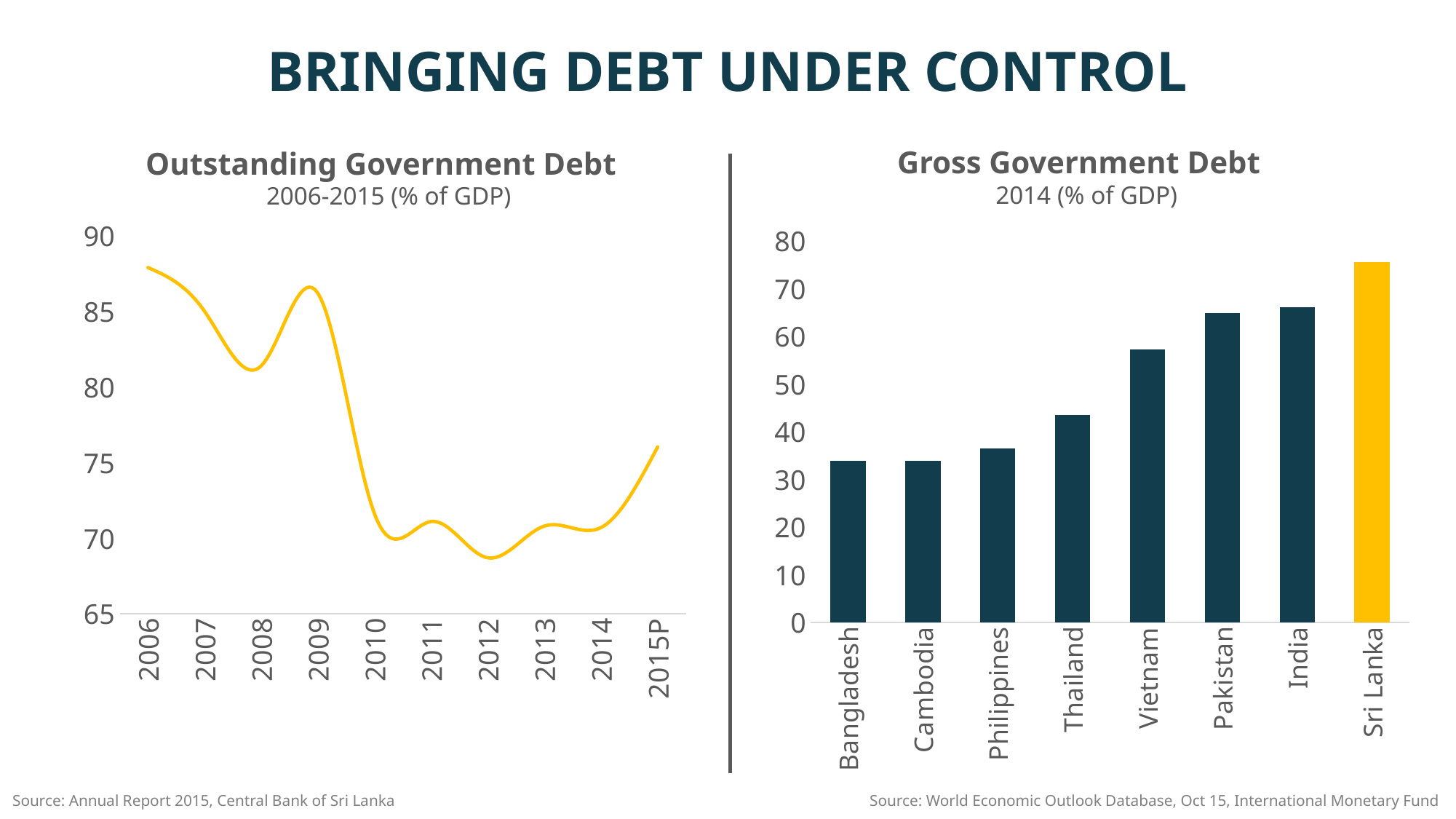
On the Gross Government Debt chart, is the value for Sri Lanka greater or less than 70? greater On the Outstanding Government Debt chart, which year has the highest value? 2006 On the Gross Government Debt chart, how many countries are shown? 8 What kind of chart is the Gross Government Debt chart? bar chart On the Gross Government Debt chart, is the value for Philippines greater or less than 40? less What kind of chart is the Outstanding Government Debt chart? line chart On the Gross Government Debt chart, which is larger, the value for Vietnam or the value for Thailand? Vietnam On the Outstanding Government Debt chart, which year has the lowest value? 2012 On the Gross Government Debt chart, is the value for Thailand greater or less than 40? greater On the Gross Government Debt chart, which country has the highest value? Sri Lanka On the Gross Government Debt chart, which bar is coloured yellow rather than dark blue? Sri Lanka